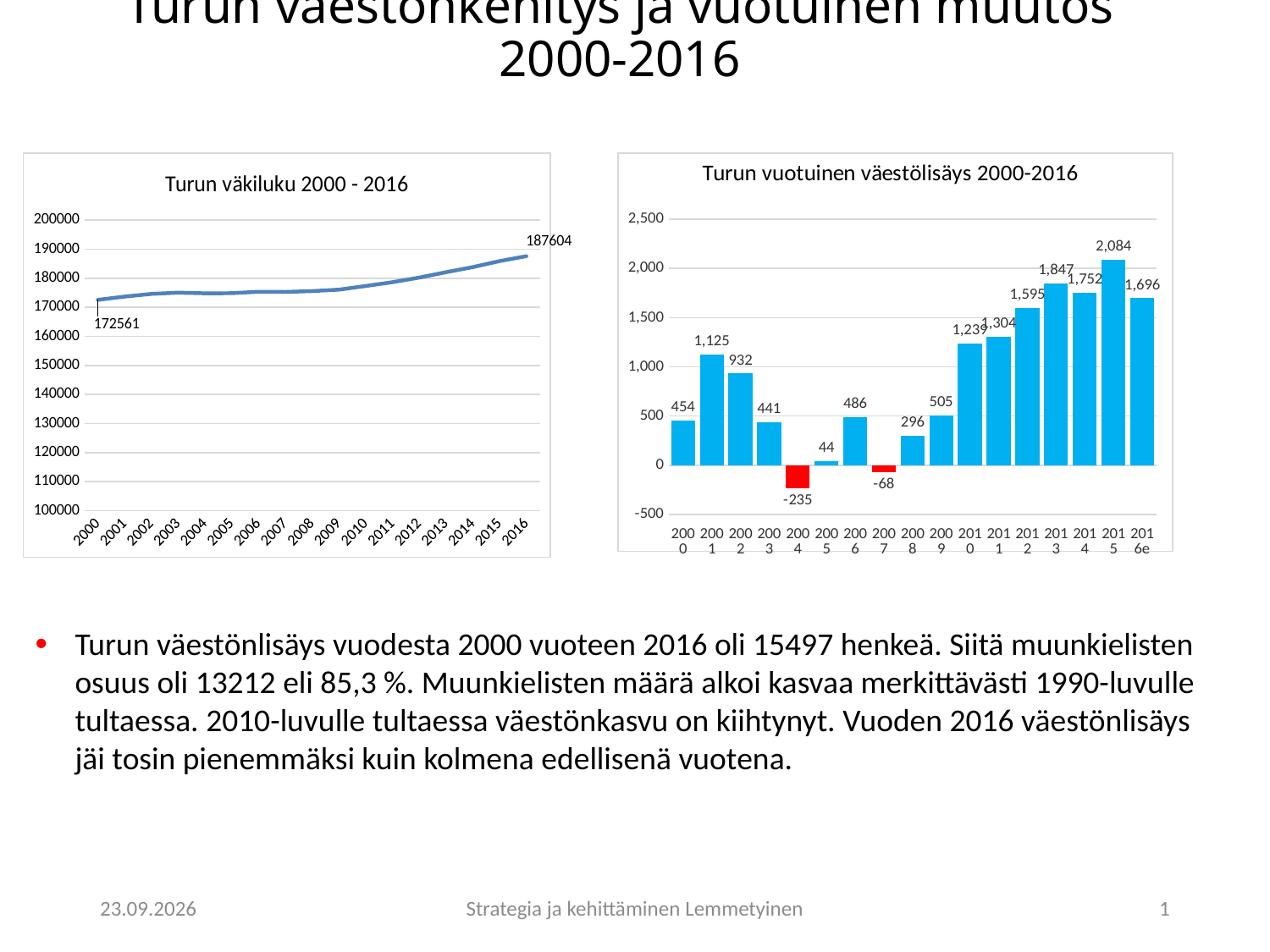
In the chart titled 'Turun vuotuinen väestölisäys 2000-2016', what is the difference between the values for 2013 and 2014? 95 In the chart titled 'Turun väkiluku 2000 - 2016', what is the value shown for 2000? 172561 In the chart titled 'Turun väkiluku 2000 - 2016', do the values rise or fall from 2000 to 2016? rise In the chart titled 'Turun vuotuinen väestölisäys 2000-2016', what is the value for 2007? -68 In the chart titled 'Turun vuotuinen väestölisäys 2000-2016', which year has the highest value? 2015 What kind of chart is 'Turun vuotuinen väestölisäys 2000-2016'? bar chart In the chart titled 'Turun vuotuinen väestölisäys 2000-2016', what is the value for 2015? 2,084 In the chart titled 'Turun väkiluku 2000 - 2016', what is the value shown for 2016? 187604 In the chart titled 'Turun vuotuinen väestölisäys 2000-2016', which year has the lowest value? 2004 What kind of chart is 'Turun väkiluku 2000 - 2016'? line chart In the chart titled 'Turun väkiluku 2000 - 2016', what is the difference between the 2016 value and the 2000 value? 15043 In the chart titled 'Turun vuotuinen väestölisäys 2000-2016', which is larger, the value for 2001 or the value for 2002? 2001